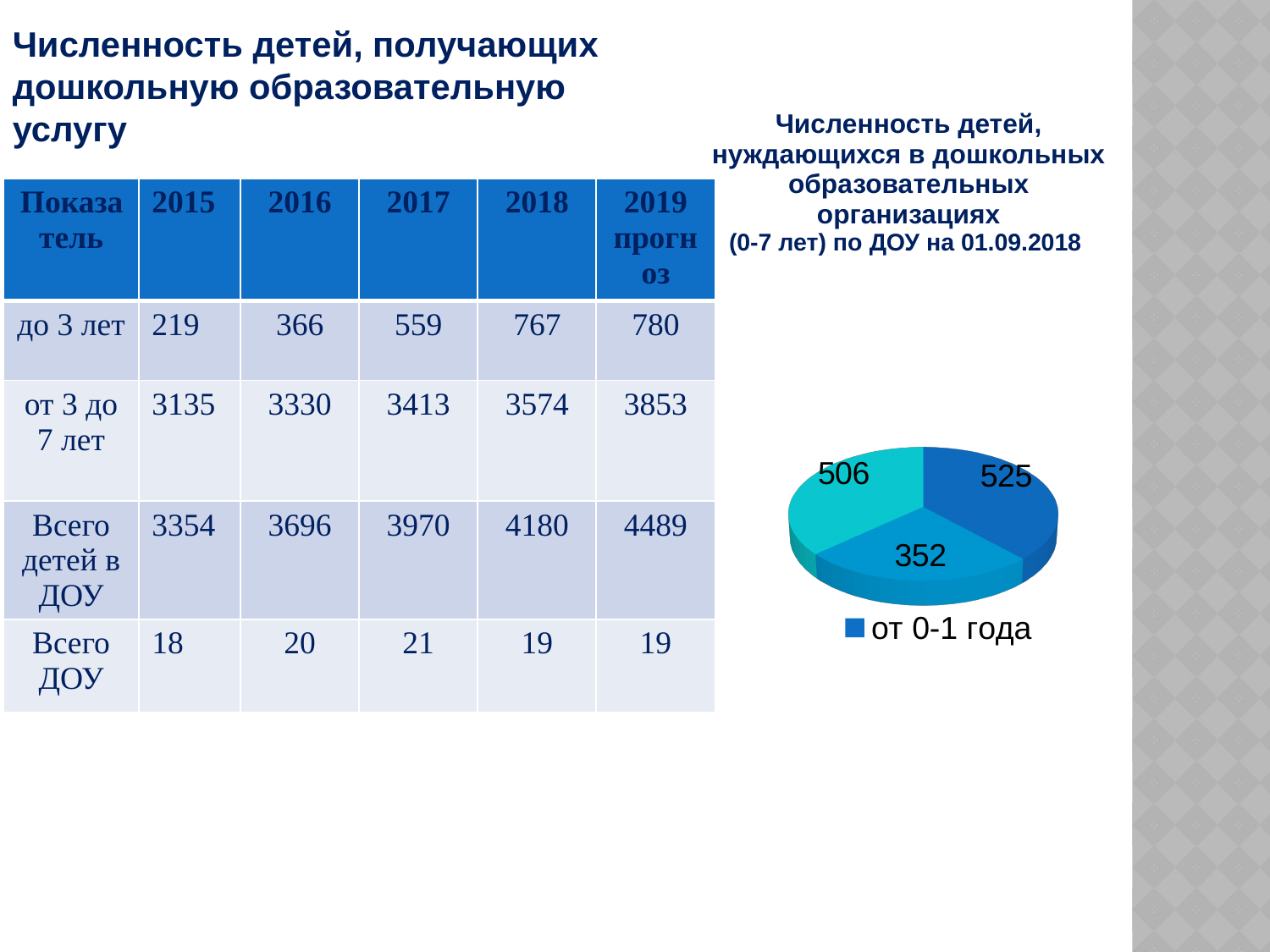
What is the difference between the slices labelled 506 and 352 in the pie chart? 154 What kind of chart is shown on the right of the slide? pie chart What is the value of the slice labelled 'от 0-1 года' in the pie chart? 525 What is the smallest value shown on the pie chart? 352 What share of the pie chart does the slice labelled 525 represent? 38% What is the difference between the largest and smallest slices of the pie chart? 173 What is the total of all three slices in the pie chart? 1383 How many slices does the pie chart have? 3 What legend entry is shown below the pie chart? от 0-1 года What is the largest value shown on the pie chart? 525 What is the date given in the pie chart's title? 01.09.2018 Which slice of the pie chart is larger, the one labelled 525 or the one labelled 506? 525